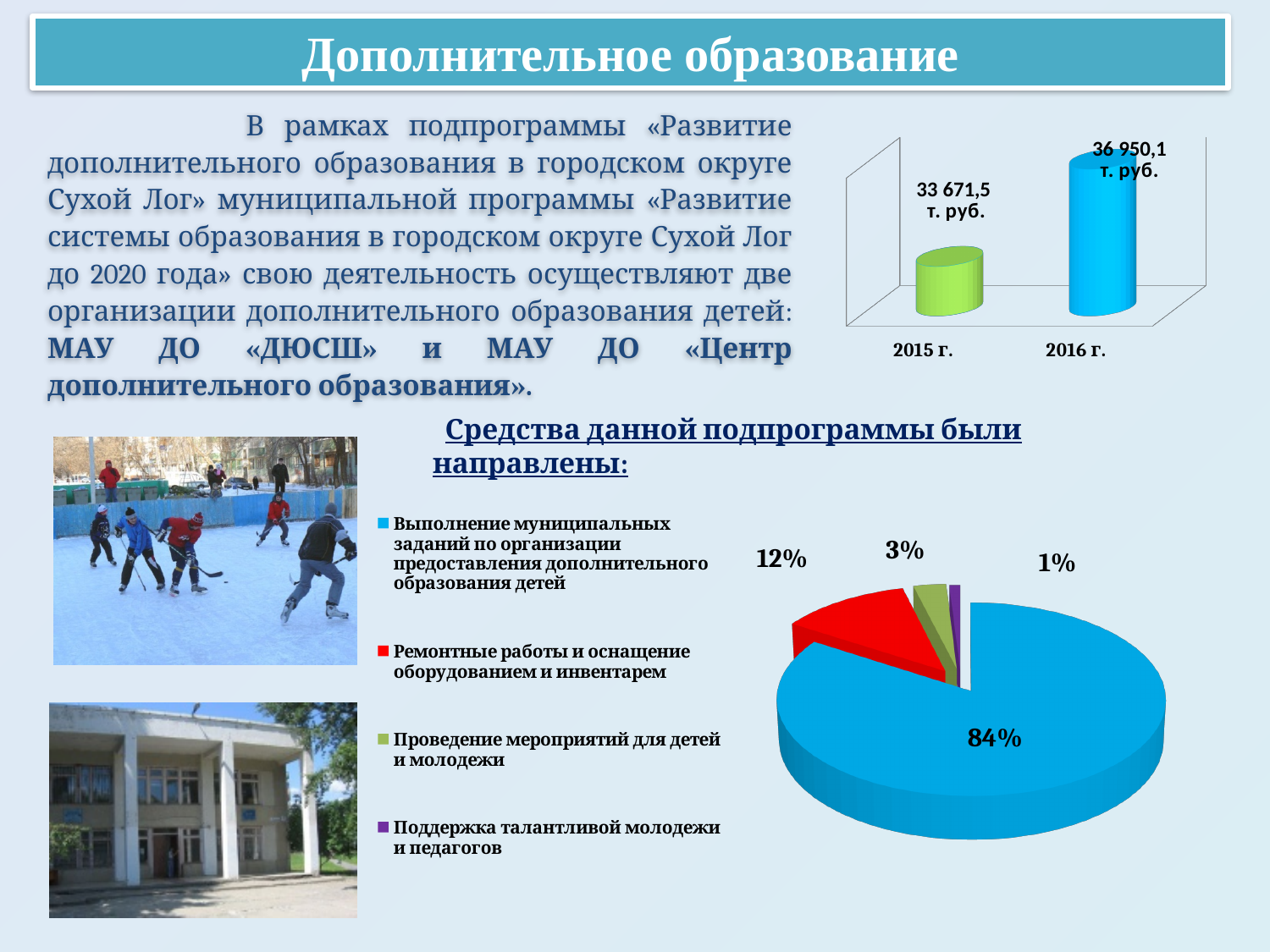
In the pie chart at the bottom right, which legend entry corresponds to the smallest slice (1%)? Поддержка талантливой молодежи и педагогов In the bar chart at the top right, which year has the lower value? 2015 г. In the bar chart at the top right, what is the value for 2016 г.? 36 950,1 т. руб. In the pie chart at the bottom right, what share corresponds to 'Ремонтные работы и оснащение оборудованием и инвентарем'? 12% In the bar chart at the top right, what is the difference between the 2016 г. and 2015 г. values? 3 278,6 т. руб. How many entries does the legend of the pie chart at the bottom right list? 4 In the pie chart at the bottom right, what share is labelled for the largest slice? 84% In the bar chart at the top right, how many categories are shown? 2 In the bar chart at the top right, what is the value for 2015 г.? 33 671,5 т. руб. In the bar chart at the top right, do the values rise or fall from 2015 г. to 2016 г.? rise What kind of chart is shown at the top right of the slide? bar chart In the bar chart at the top right, which year has the higher value? 2016 г.